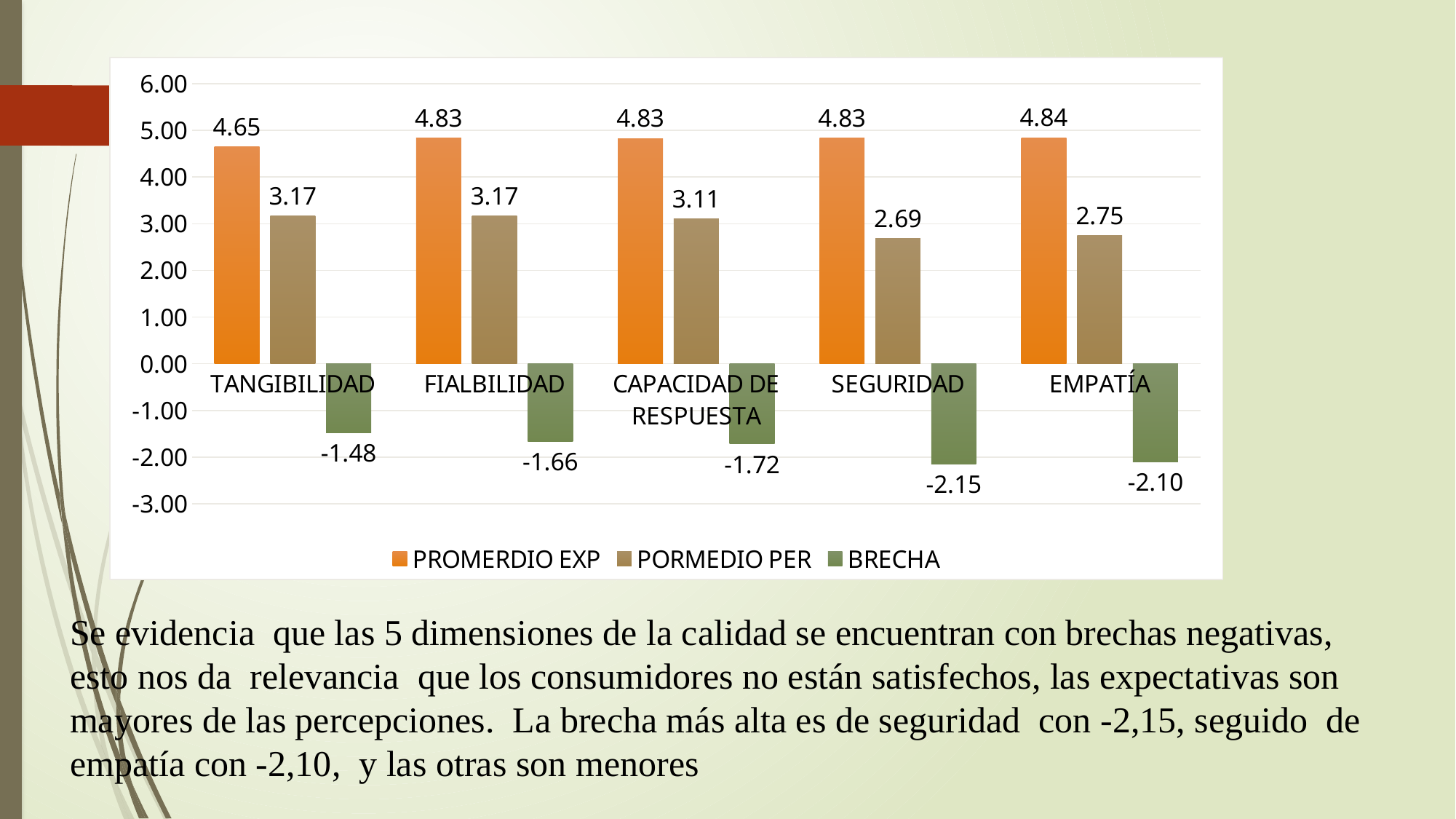
How many categories are shown on the x axis? 5 Which category has the highest PROMERDIO EXP value? EMPATÍA Which category has the lowest PORMEDIO PER value? SEGURIDAD Which category has the lowest BRECHA value? SEGURIDAD Which is larger, the PORMEDIO PER value for TANGIBILIDAD or for EMPATÍA? TANGIBILIDAD What colour are the BRECHA bars? Green What kind of chart is shown on the slide? Bar chart What is the BRECHA value for CAPACIDAD DE RESPUESTA? -1.72 What is the difference between the PROMERDIO EXP and PORMEDIO PER values for FIALBILIDAD? 1.66 What is the PROMERDIO EXP value for TANGIBILIDAD? 4.65 What is the PORMEDIO PER value for SEGURIDAD? 2.69 How many series does the legend list? 3